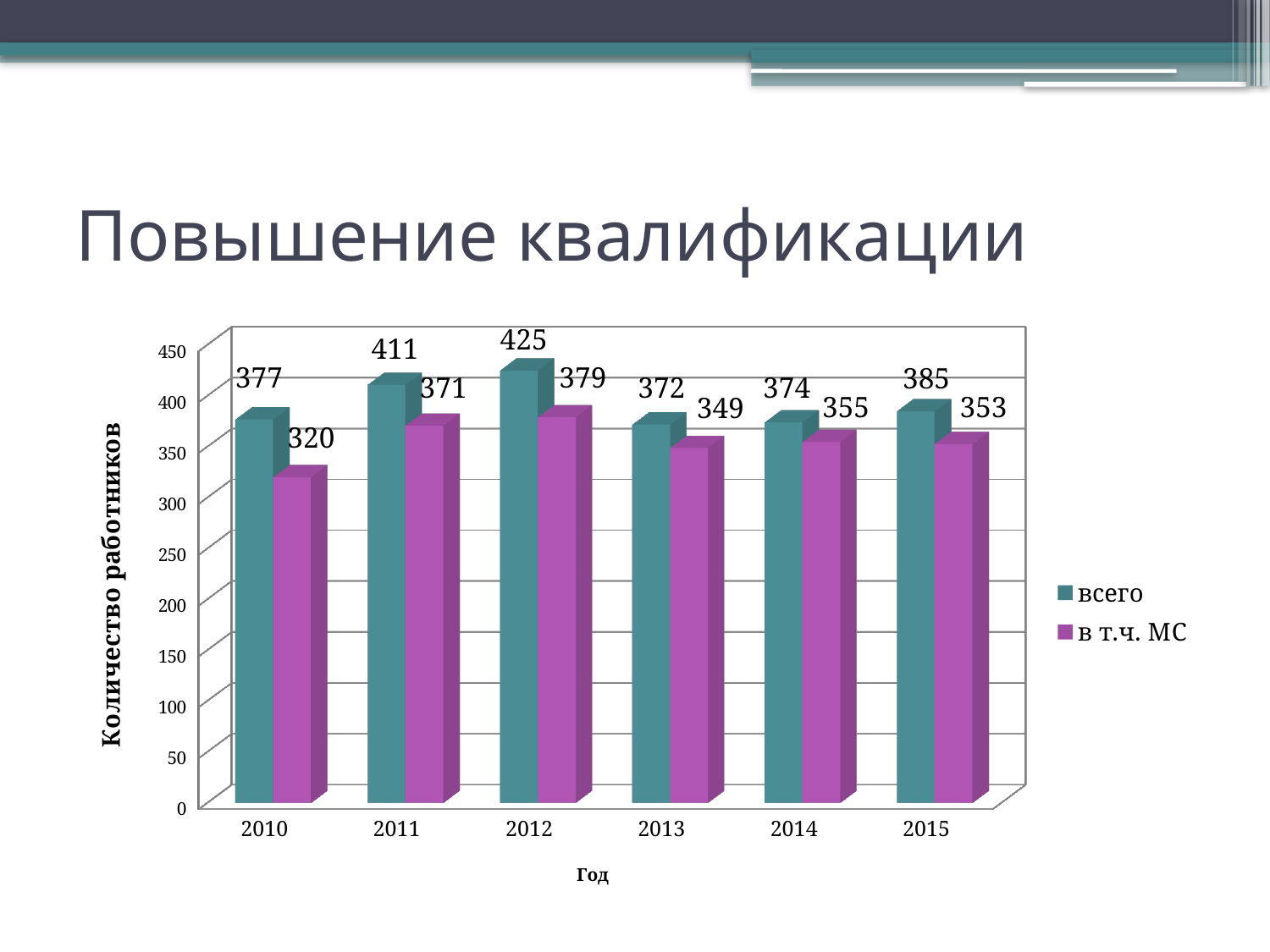
What is the title of the slide? Повышение квалификации In which year is the "в т.ч. МС" value lowest? 2010 What is the value for "всего" in 2012? 425 What is the value for "в т.ч. МС" in 2014? 355 How many years are shown on the x axis? 6 What is the difference between the "всего" values for 2012 and 2013? 53 How many series does the legend list? 2 What is the difference between "всего" and "в т.ч. МС" in 2010? 57 What kind of chart is shown on the slide? Bar chart What is the value for "в т.ч. МС" in 2010? 320 Which is larger: the "в т.ч. МС" value in 2011 or in 2015? 2011 In which year is the "всего" value highest? 2012